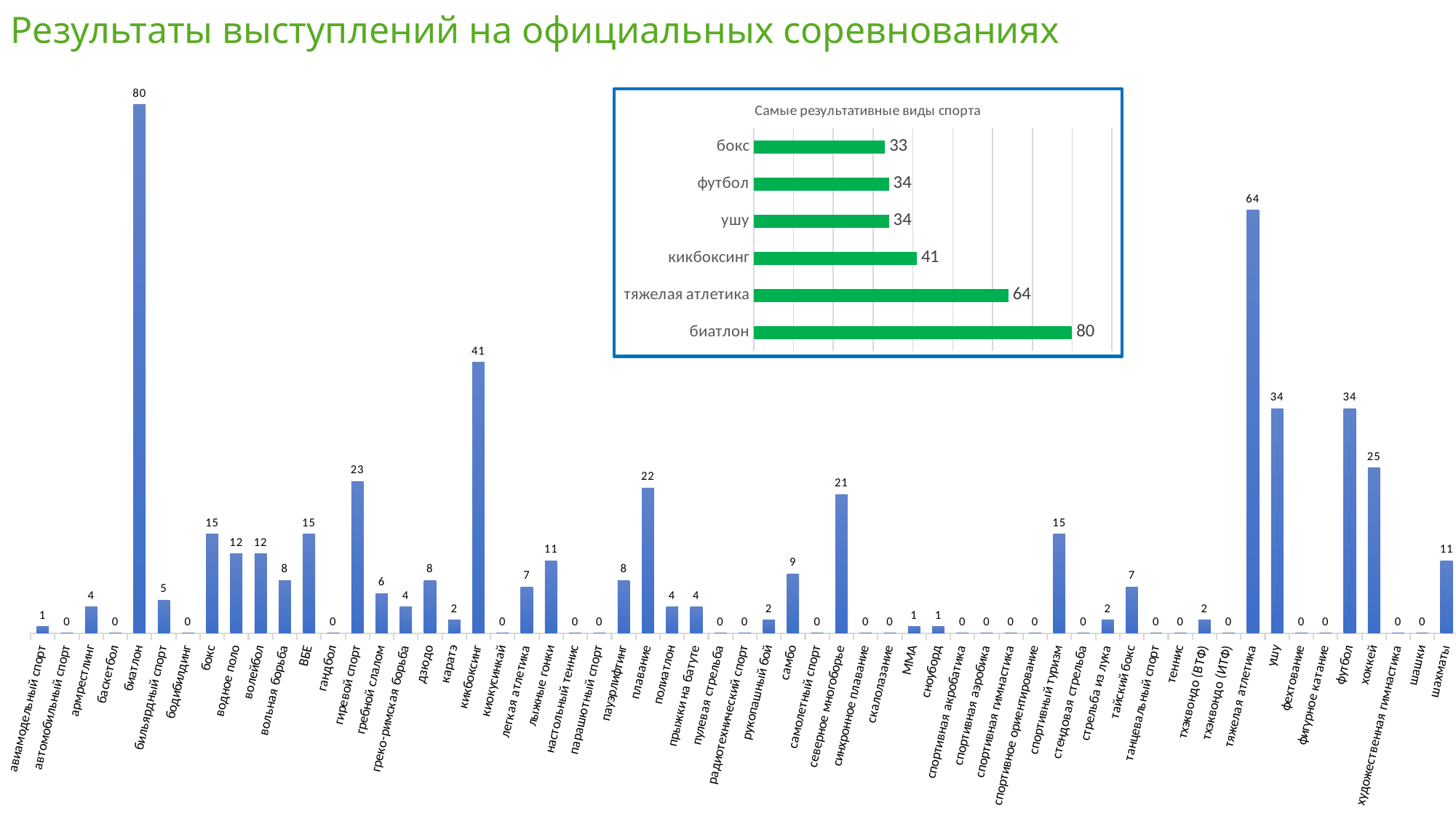
On the large blue chart, what is the value for хоккей? 25 On the inset chart 'Самые результативные виды спорта', which sport has the lowest value? бокс On the large blue chart, what is the value for северное многоборье? 21 On the inset chart 'Самые результативные виды спорта', what is the difference between the values for биатлон and тяжелая атлетика? 16 On the large blue chart, what is the value for тяжелая атлетика? 64 On the large blue chart, which has the larger value: гиревой спорт or плавание? гиревой спорт What is the title of the inset chart on the slide? Самые результативные виды спорта How many sports are shown on the inset chart 'Самые результативные виды спорта'? 6 On the large blue chart, what is the difference between the values for ушу and шахматы? 23 What kind of chart is the inset chart 'Самые результативные виды спорта'? bar chart On the inset chart 'Самые результативные виды спорта', what is the value for кикбоксинг? 41 On the inset chart 'Самые результативные виды спорта', which sport has the highest value? биатлон